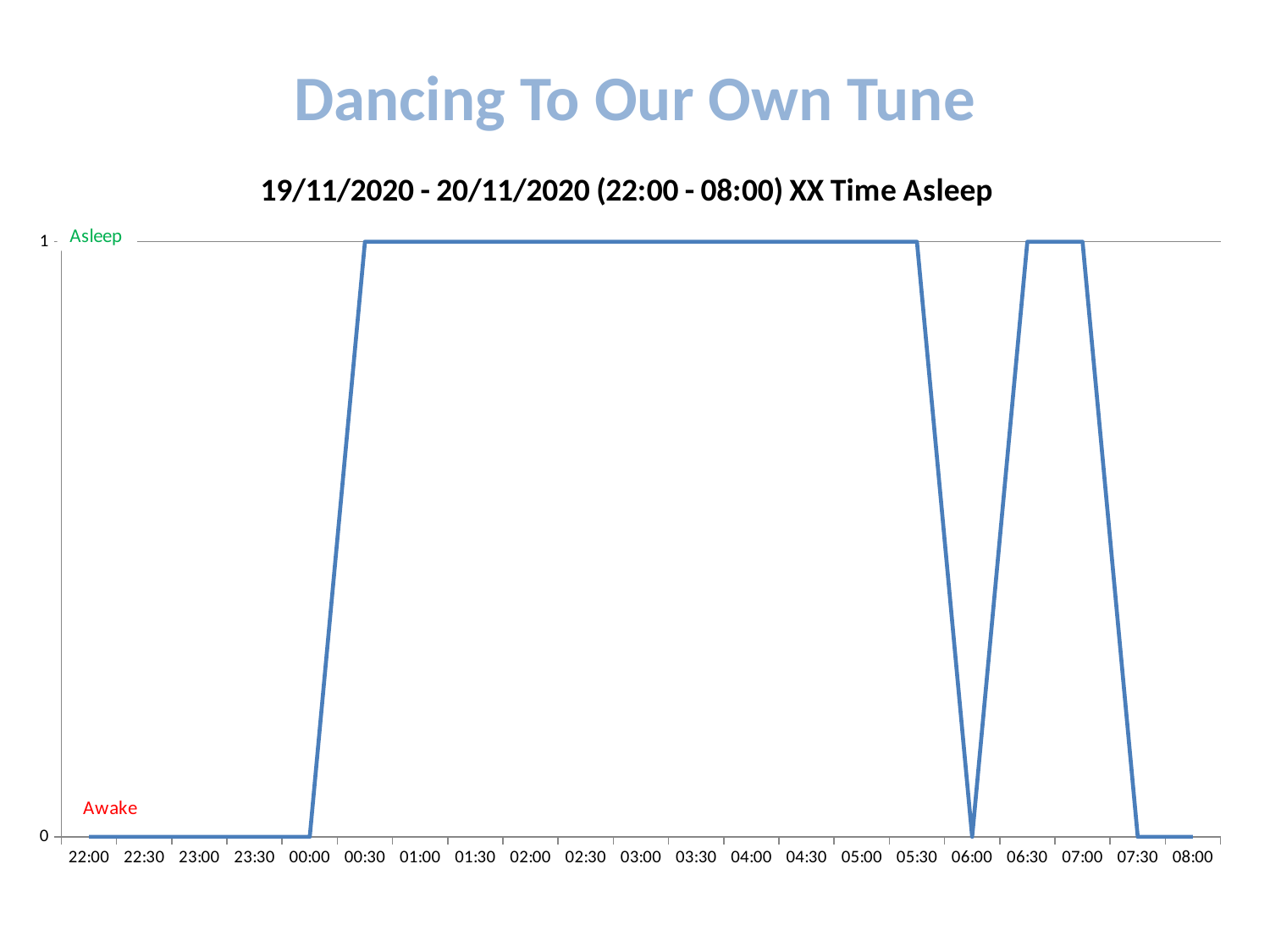
What is the value of the line at 22:00? 0 What is the title of the chart? 19/11/2020 - 20/11/2020 (22:00 - 08:00) XX Time Asleep What is the value of the line at 06:00? 0 How many time points are labelled on the x axis? 21 Does the line rise or fall between 07:00 and 07:30? Fall Which state does the value 1 on the y axis represent? Asleep What is the value of the line at 08:00? 0 What is the value of the line at 06:30? 1 Is the value at 00:30 larger or smaller than the value at 00:00? Larger What is the value of the line at 02:00? 1 What is the difference between the value at 05:30 and the value at 06:00? 1 What type of chart is shown on the slide? Line chart